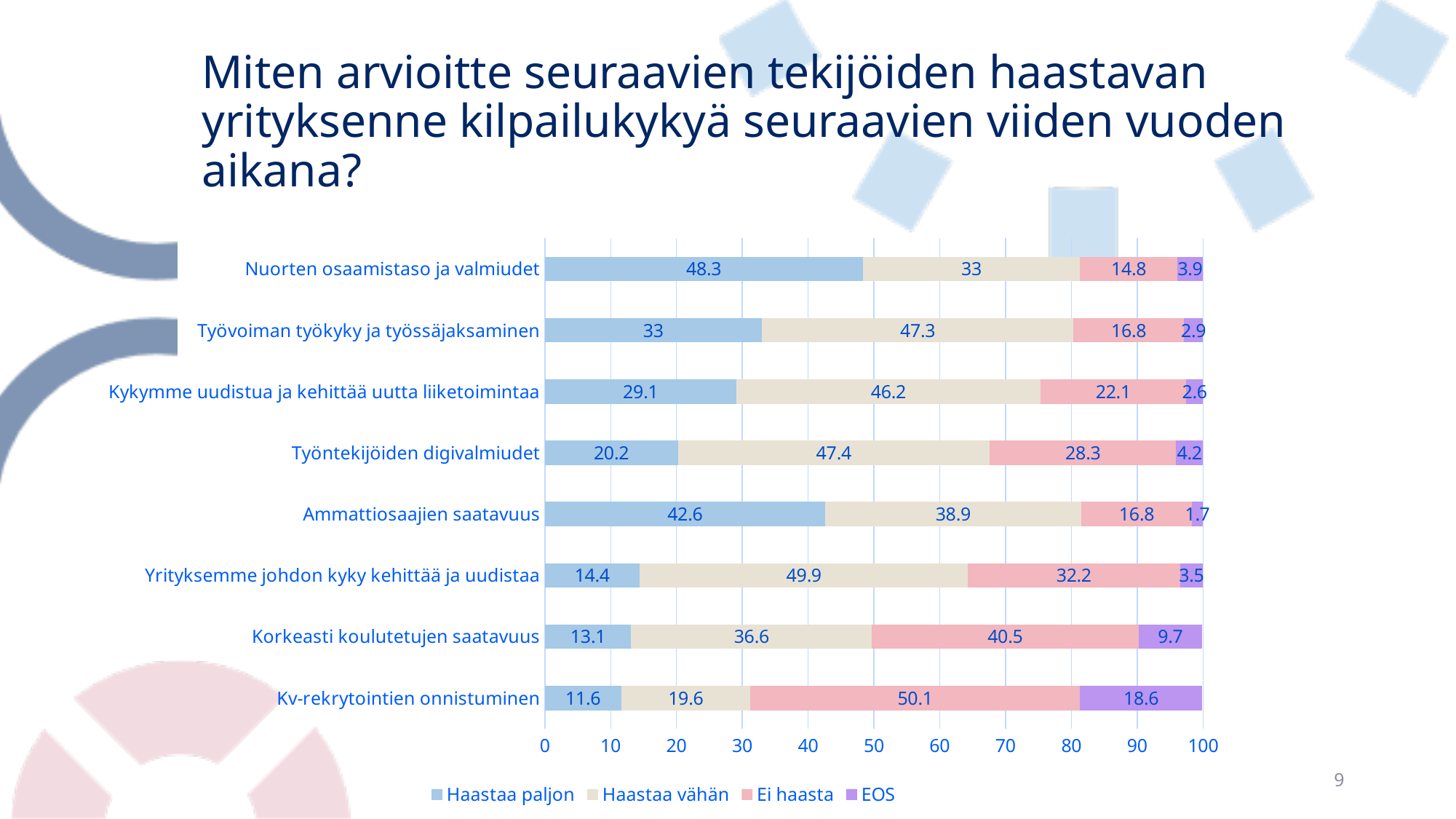
What is the "Haastaa paljon" value for Nuorten osaamistaso ja valmiudet? 48.3 How many categories are shown on the chart? 8 Which category has the highest "Haastaa paljon" value? Nuorten osaamistaso ja valmiudet Which category has the lowest "Haastaa paljon" value? Kv-rekrytointien onnistuminen What is the total of the stacked bar for Kv-rekrytointien onnistuminen? 99.9 What is the "Ei haasta" value for Korkeasti koulutetujen saatavuus? 40.5 What kind of chart is shown on the slide? Stacked bar chart How many series does the legend list? 4 Which category has the highest "Ei haasta" value? Kv-rekrytointien onnistuminen For Ammattiosaajien saatavuus, which is larger: "Haastaa paljon" or "Haastaa vähän"? Haastaa paljon What is the difference between the "Haastaa paljon" values for Nuorten osaamistaso ja valmiudet and Kv-rekrytointien onnistuminen? 36.7 What is the "EOS" value for Kv-rekrytointien onnistuminen? 18.6